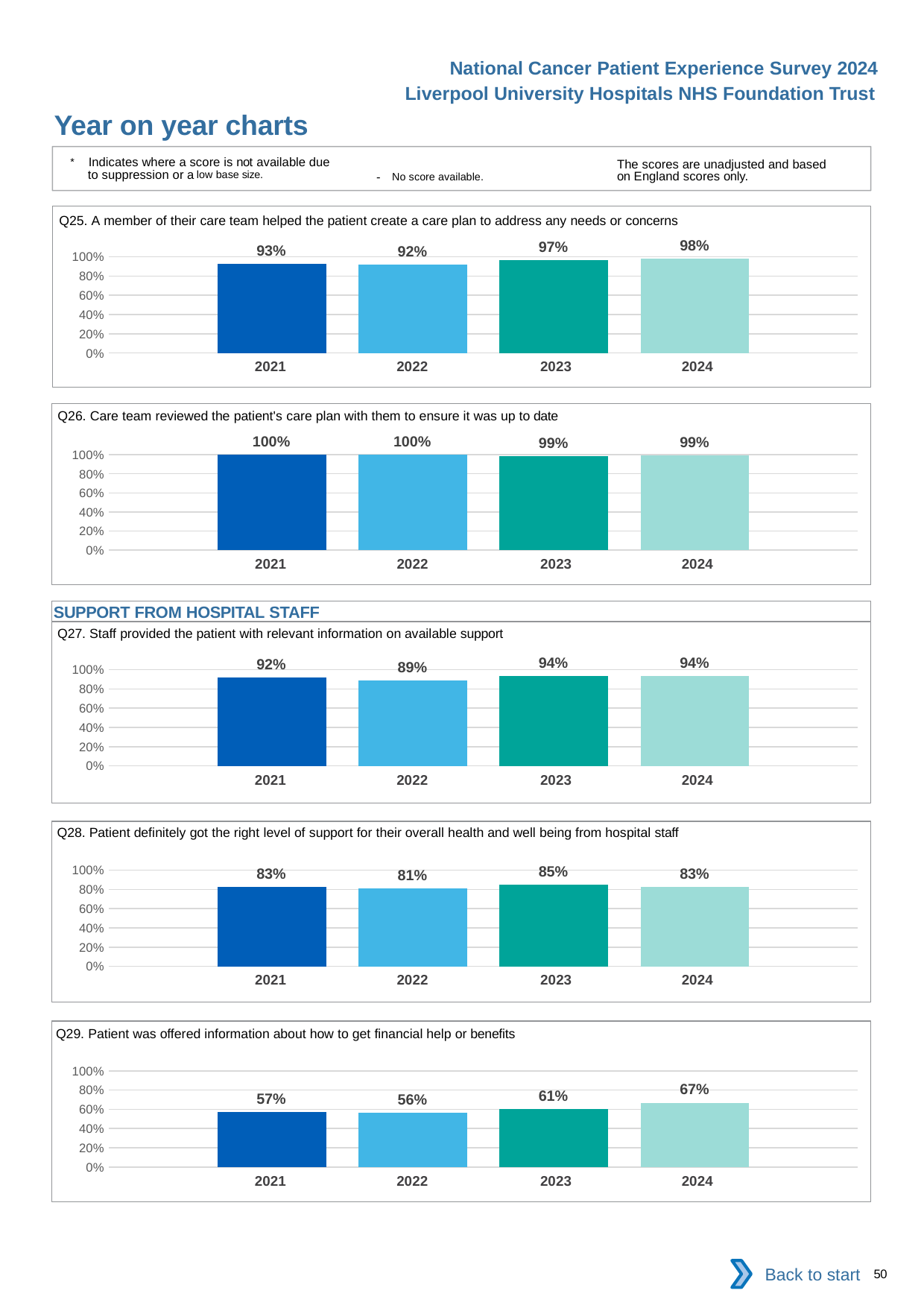
What kind of chart is the Q25 chart? bar chart In the Q26 chart, what is the value for 2021? 100% In the Q25 chart, what is the value for 2024? 98% How many years are shown in the Q29 chart? 4 In the Q28 chart, what is the difference between the 2023 and 2022 values? 4% In the Q29 chart, is the value for 2021 greater or less than 60%? less In the Q29 chart, what is the value for 2024? 67% In the Q27 chart, what is the value for 2023? 94% In the Q26 chart, what is the difference between the 2021 and 2024 values? 1% In the Q25 chart, which year has the lowest value? 2022 In the Q27 chart, which year has the lowest value? 2022 In the Q28 chart, which year has the highest value? 2023